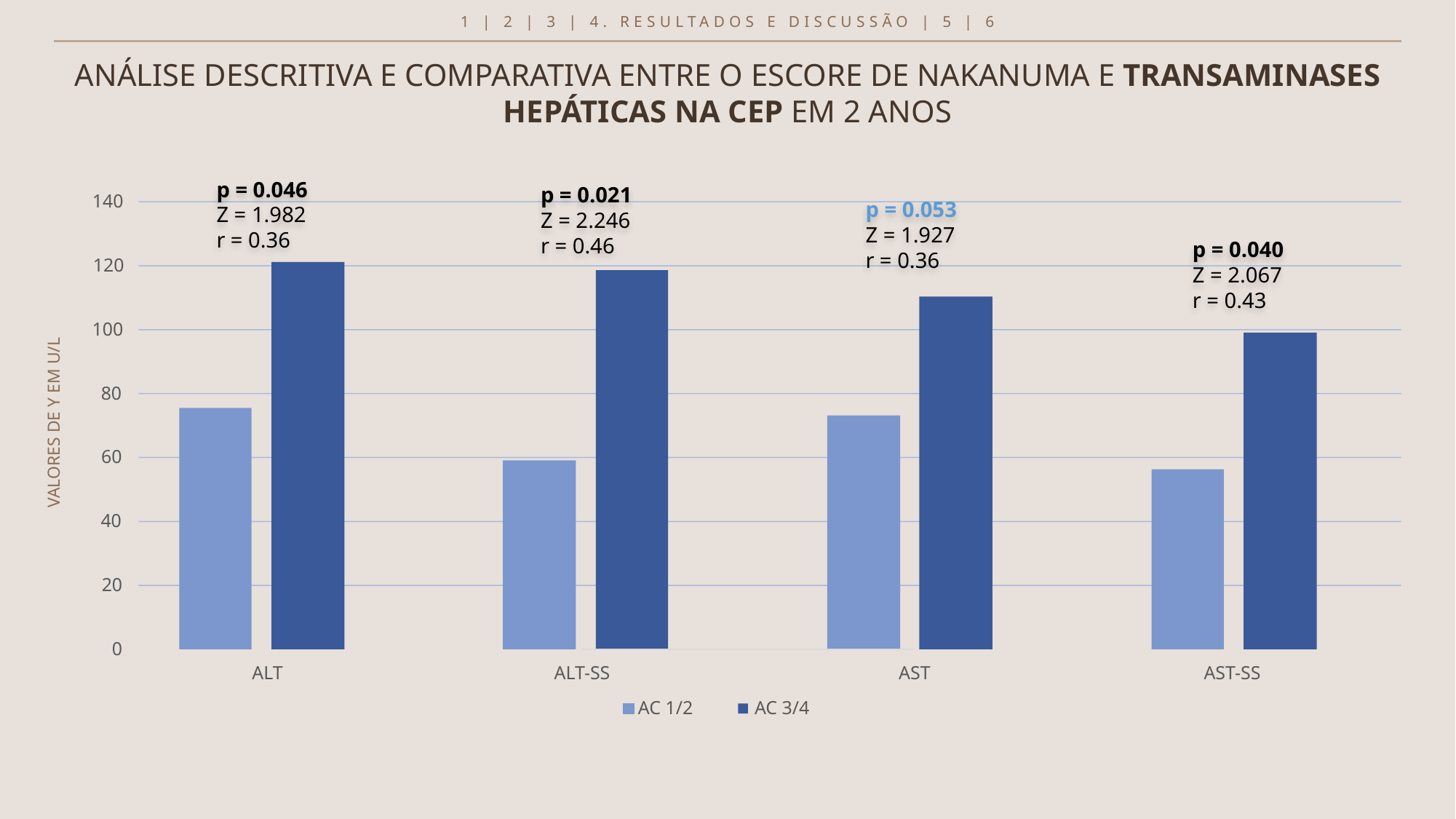
How many series does the chart legend list? 2 Is the AC 3/4 value for ALT greater or less than 100? greater What p value is printed above the AST bars? p = 0.053 What kind of chart is shown on the slide? bar chart Is the AC 1/2 value for ALT-SS greater or less than 80? less For which category is the AC 3/4 bar the lowest? AST-SS What is the label of the vertical axis? VALORES DE Y EM U/L Which series has the lowest value for AST-SS, AC 1/2 or AC 3/4? AC 1/2 Which is larger for ALT-SS, the AC 1/2 value or the AC 3/4 value? AC 3/4 Do the AC 3/4 values rise or fall from ALT to AST-SS along the x axis? fall Is the AC 3/4 value for AST-SS greater or less than 120? less How many categories are shown on the x axis of the chart? 4